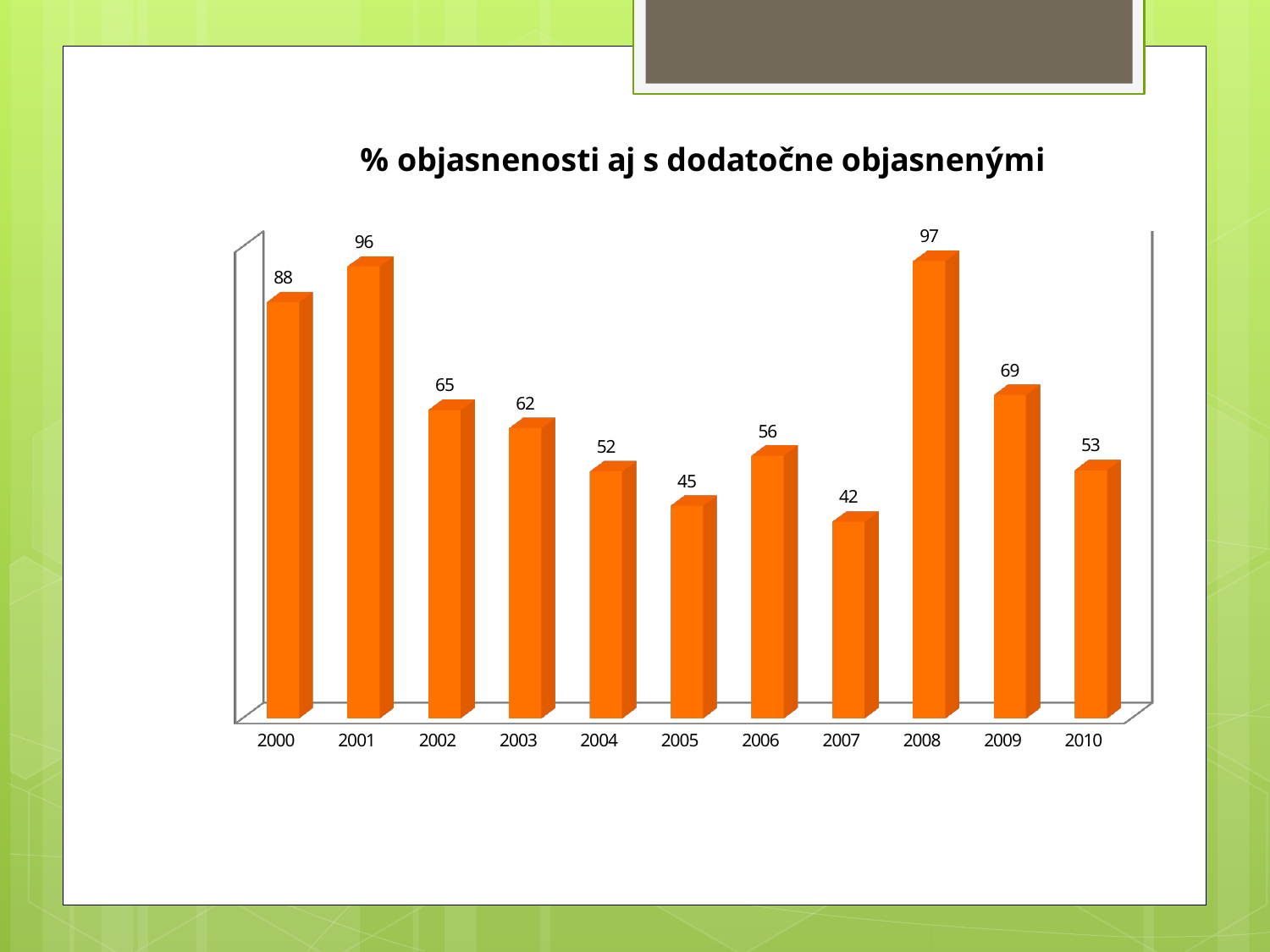
Do the values rise or fall from 2001 to 2005? fall What colour are the bars in the chart? orange Which year has the lowest value? 2007 What is the difference between the values for 2001 and 2002? 31 What is the value for 2008? 97 What is the value for 2005? 45 What is the value for 2000? 88 What kind of chart is shown on the slide? bar chart What is the title of the chart? % objasnenosti aj s dodatočne objasnenými Which year has the highest value? 2008 Which is larger, the value for 2009 or the value for 2010? 2009 How many years are shown on the x axis? 11